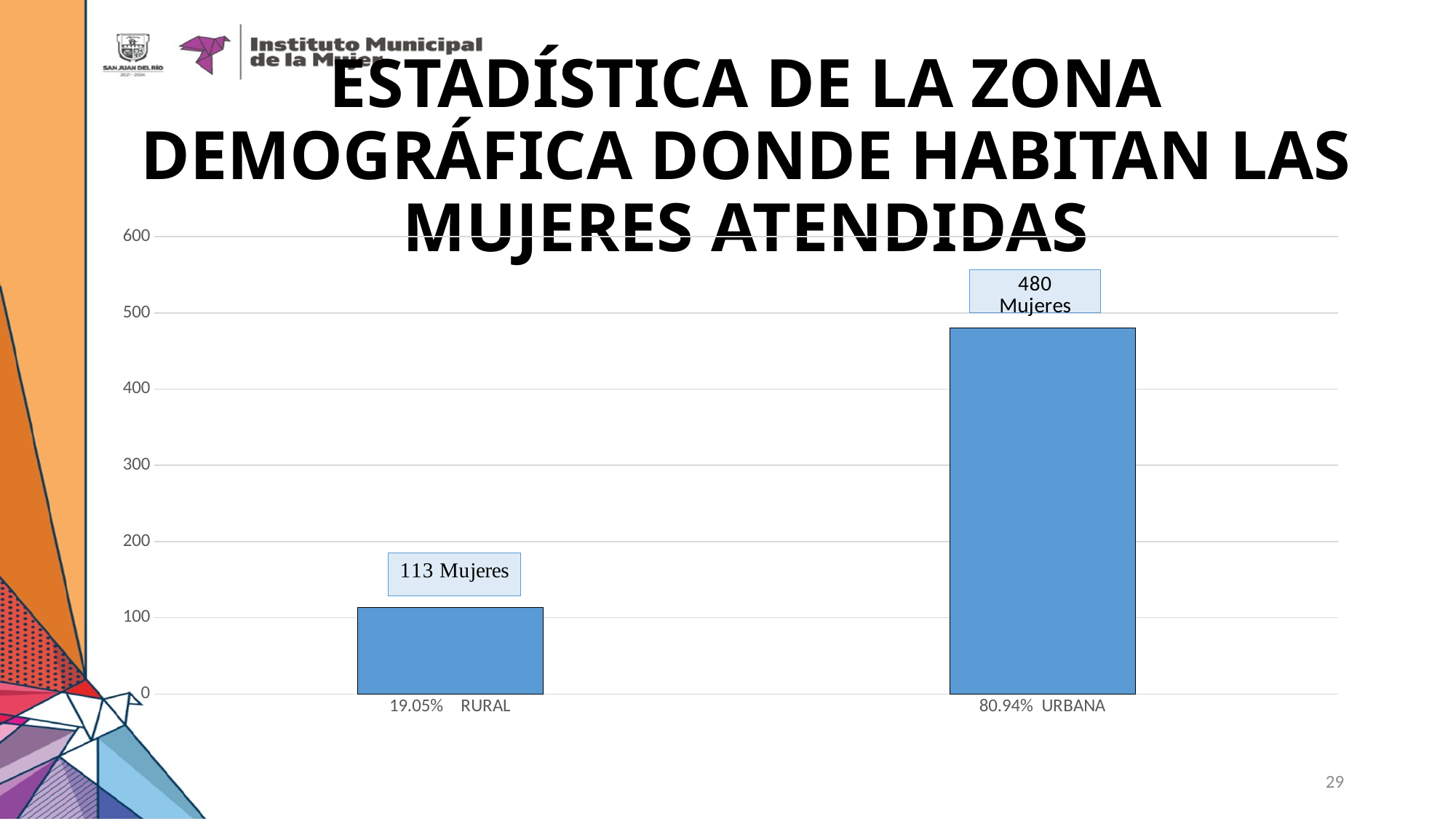
Which category has the lowest value? RURAL How many categories are shown on the chart? 2 What percentage is shown next to the RURAL category label? 19.05% Which is larger, the value for RURAL or the value for URBANA? URBANA What is the difference between the URBANA and RURAL values? 367 Which category has the highest value? URBANA How many women (mujeres) are shown for the RURAL category? 113 Mujeres Is the value for RURAL greater or less than 200? less What percentage is shown next to the URBANA category label? 80.94% What kind of chart is shown on the slide? Bar chart How many women (mujeres) are shown for the URBANA category? 480 Mujeres Is the value for URBANA greater or less than 400? greater